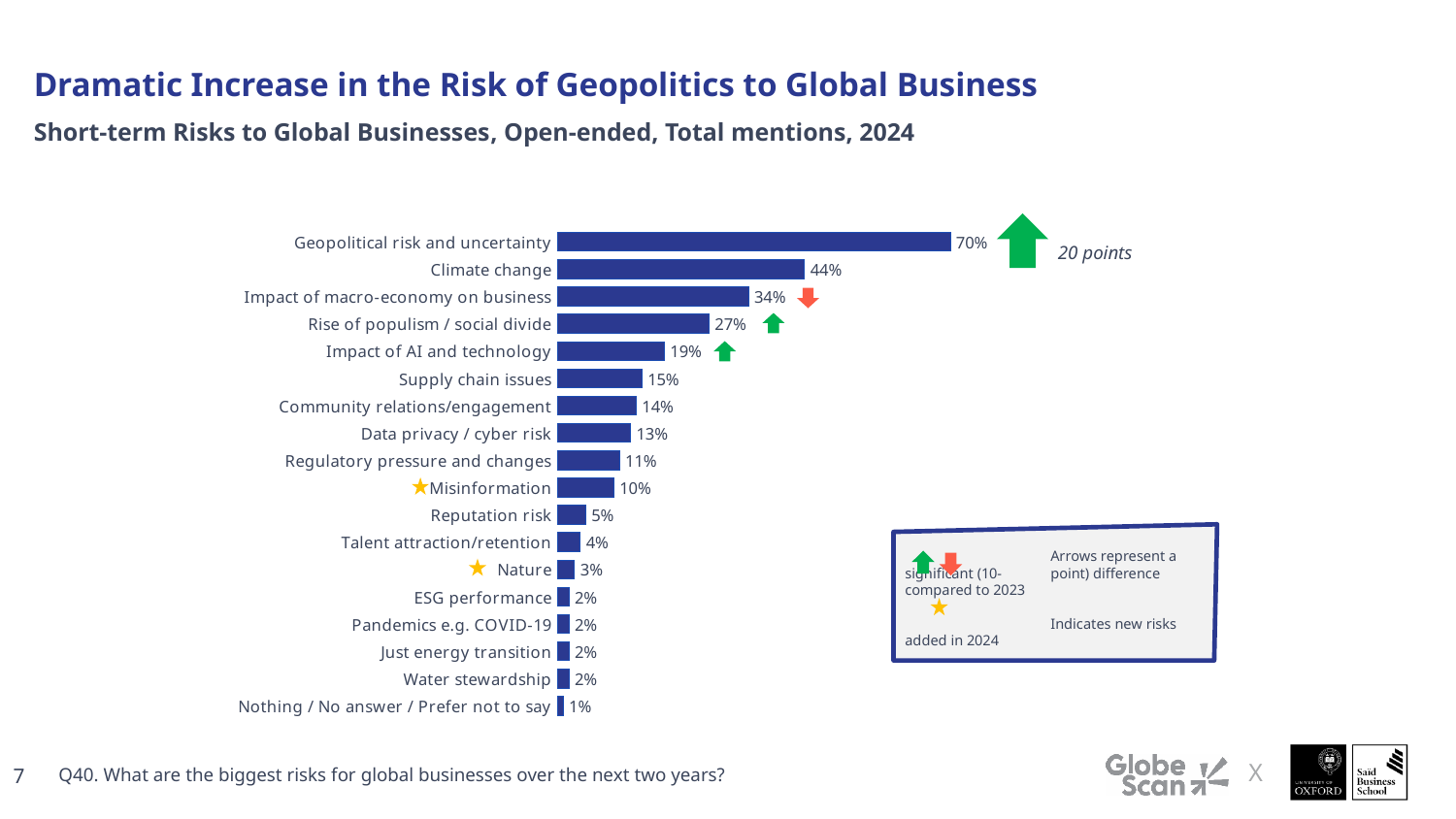
What percentage is shown for Impact of AI and technology? 19% According to the annotation next to the top bar, by how many points did Geopolitical risk and uncertainty increase? 20 points Which is larger, Supply chain issues or Data privacy / cyber risk? Supply chain issues What is the value shown for Climate change? 44% What percentage of mentions does Geopolitical risk and uncertainty receive? 70% How many categories are plotted on the chart? 18 What type of chart is shown on the slide? Bar chart Which category has the highest value on the chart? Geopolitical risk and uncertainty What is the value for Misinformation? 10% Which category has the lowest value on the chart? Nothing / No answer / Prefer not to say What is the difference in percentage points between Geopolitical risk and uncertainty and Climate change? 26 What is the difference between Impact of macro-economy on business and Rise of populism / social divide? 7